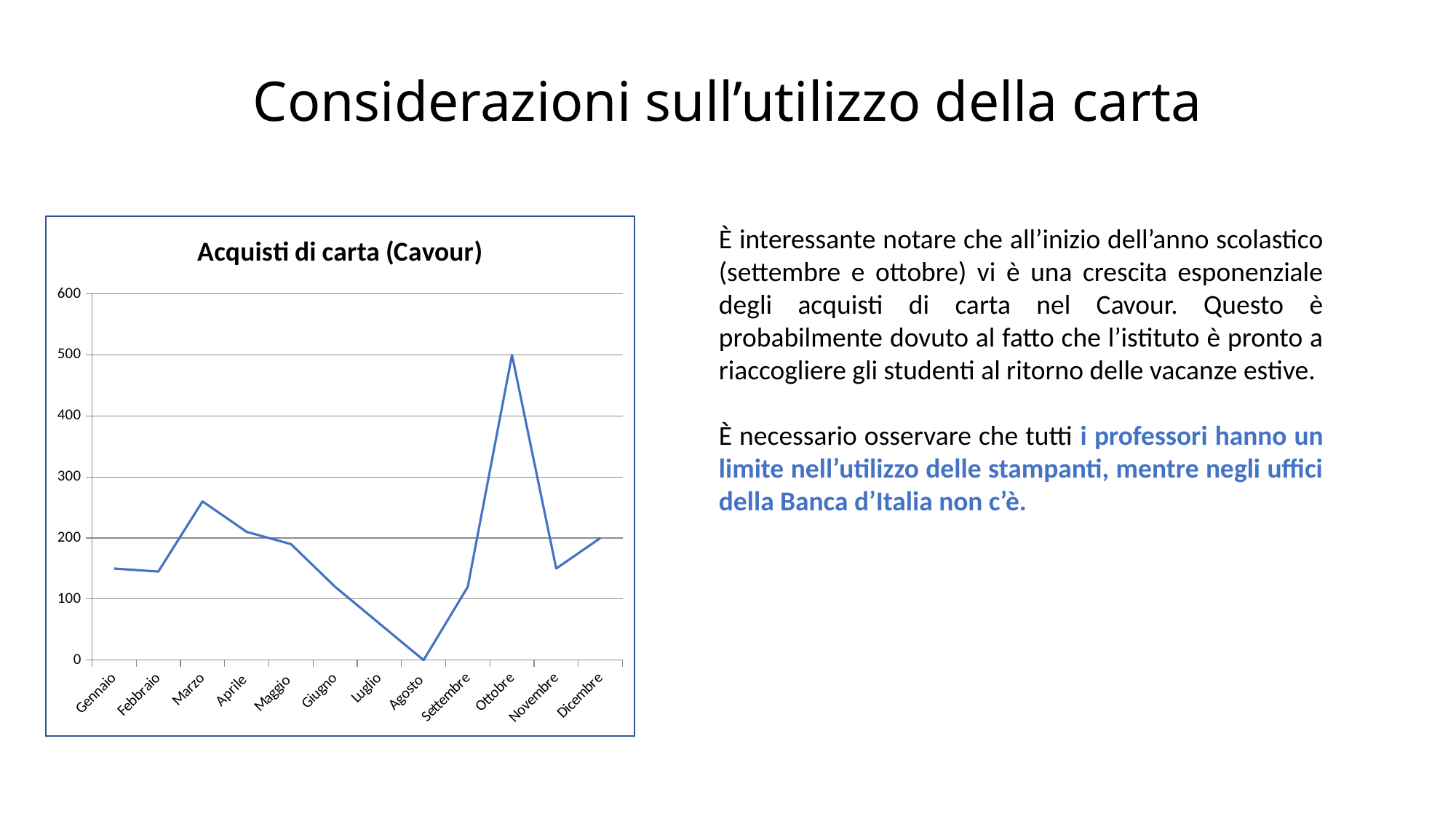
Do the values rise or fall from Agosto to Ottobre? rise Which month has the lowest value in the chart? Agosto What kind of chart is shown on the slide? line chart What is the value for Ottobre? 500 How many months are plotted on the x axis of the chart? 12 Is the value for Marzo greater or less than 200? greater What is the value for Agosto? 0 Which month has the highest value in the chart? Ottobre Which is larger, the value for Marzo or the value for Aprile? Marzo Is the value for Luglio greater or less than 100? less What is the title of the chart? Acquisti di carta (Cavour) Is the value for Novembre greater or less than 200? less